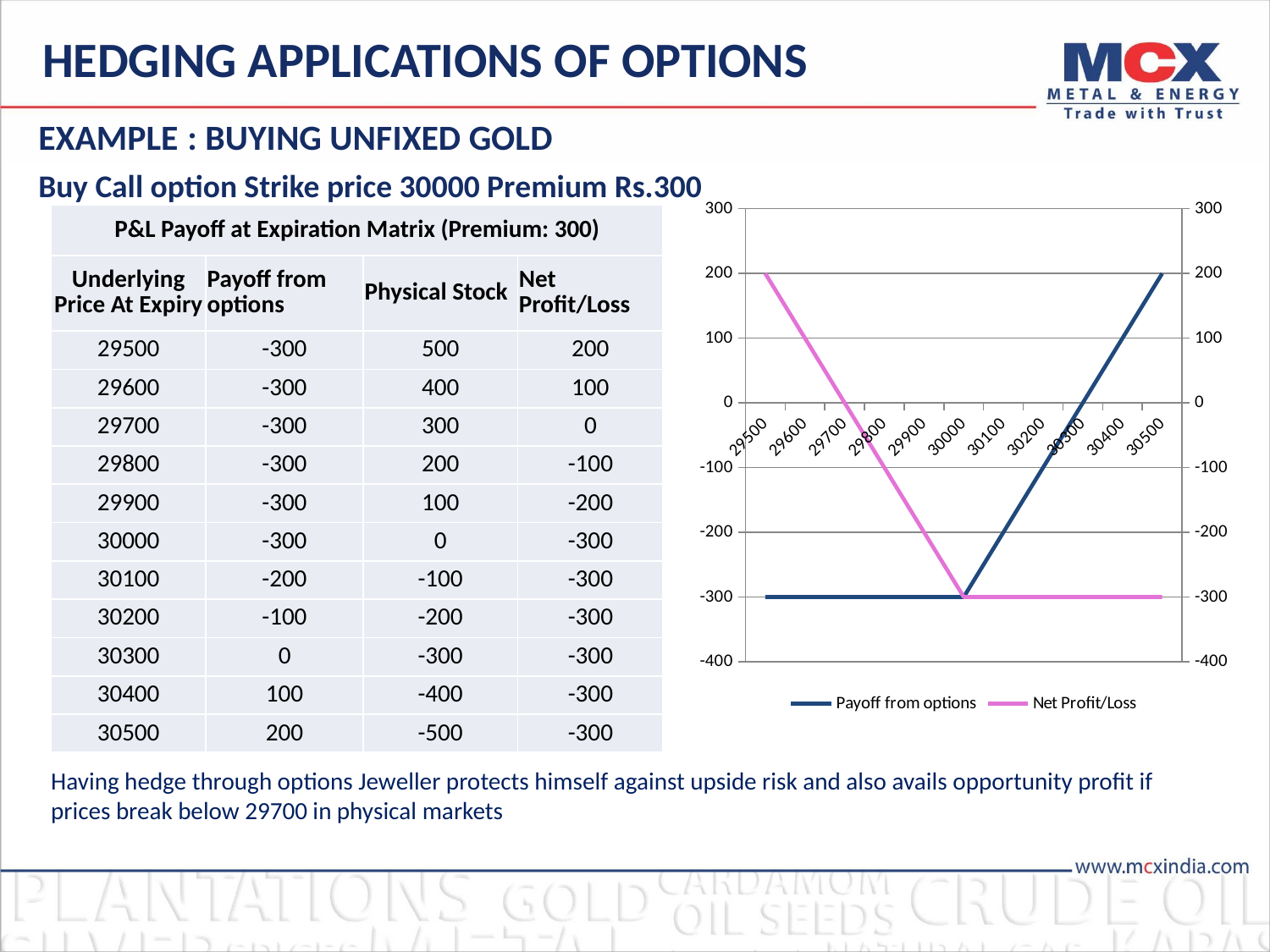
Does the Payoff from options line rise or fall as the underlying price moves from 30000 to 30500? Rises What is the highest value reached by the Payoff from options series? 200 What is the value of the Net Profit/Loss series at an underlying price of 29500? 200 What is the value of the Payoff from options series at an underlying price of 30500? 200 How many underlying price points are plotted along the x axis of the chart? 11 At which underlying price does the Payoff from options line cross zero? 30300 At an underlying price of 29500, which series has the higher value, Payoff from options or Net Profit/Loss? Net Profit/Loss How many series does the chart's legend list? 2 At an underlying price of 29500, what is the difference between the Net Profit/Loss value and the Payoff from options value? 500 Does the Net Profit/Loss line rise or fall as the underlying price moves from 29500 to 30000? Falls What is the value of the Net Profit/Loss series at an underlying price of 30000? -300 What kind of chart is shown on the slide? Line chart